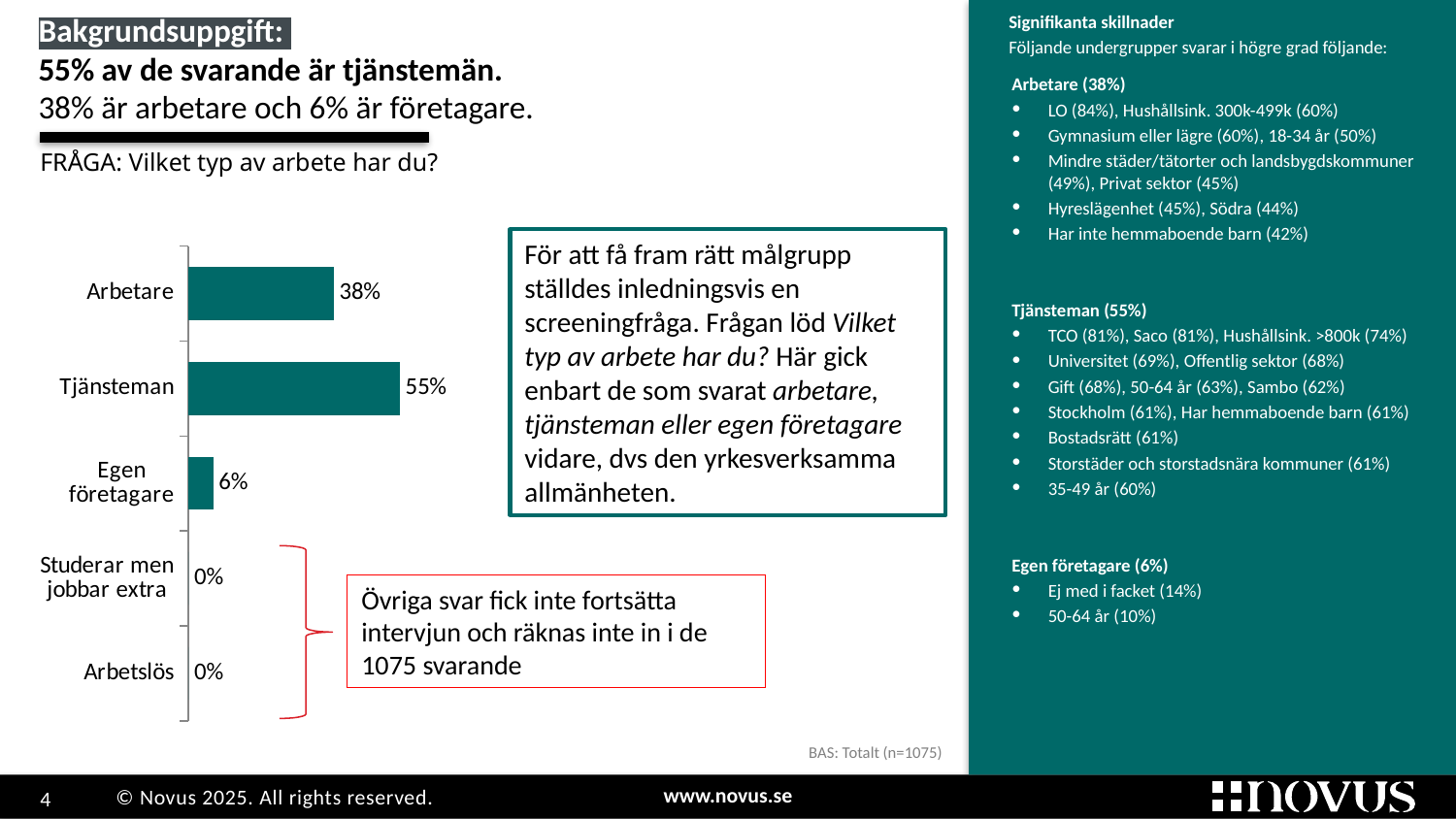
Which category has the highest value? Tjänsteman What is the difference between the values for Tjänsteman and Arbetare? 17% What colour are the bars in the chart? Teal (dark green) How many categories in the chart have a value of 0%? 2 What is the value for Tjänsteman? 55% What is the value for Egen företagare? 6% What is the value for Arbetare? 38% How many categories are shown in the chart? 5 What kind of chart is shown on the slide? Bar chart What is the value for Arbetslös? 0% What is the difference between the values for Arbetare and Egen företagare? 32% Which is larger, the value for Arbetare or the value for Egen företagare? Arbetare